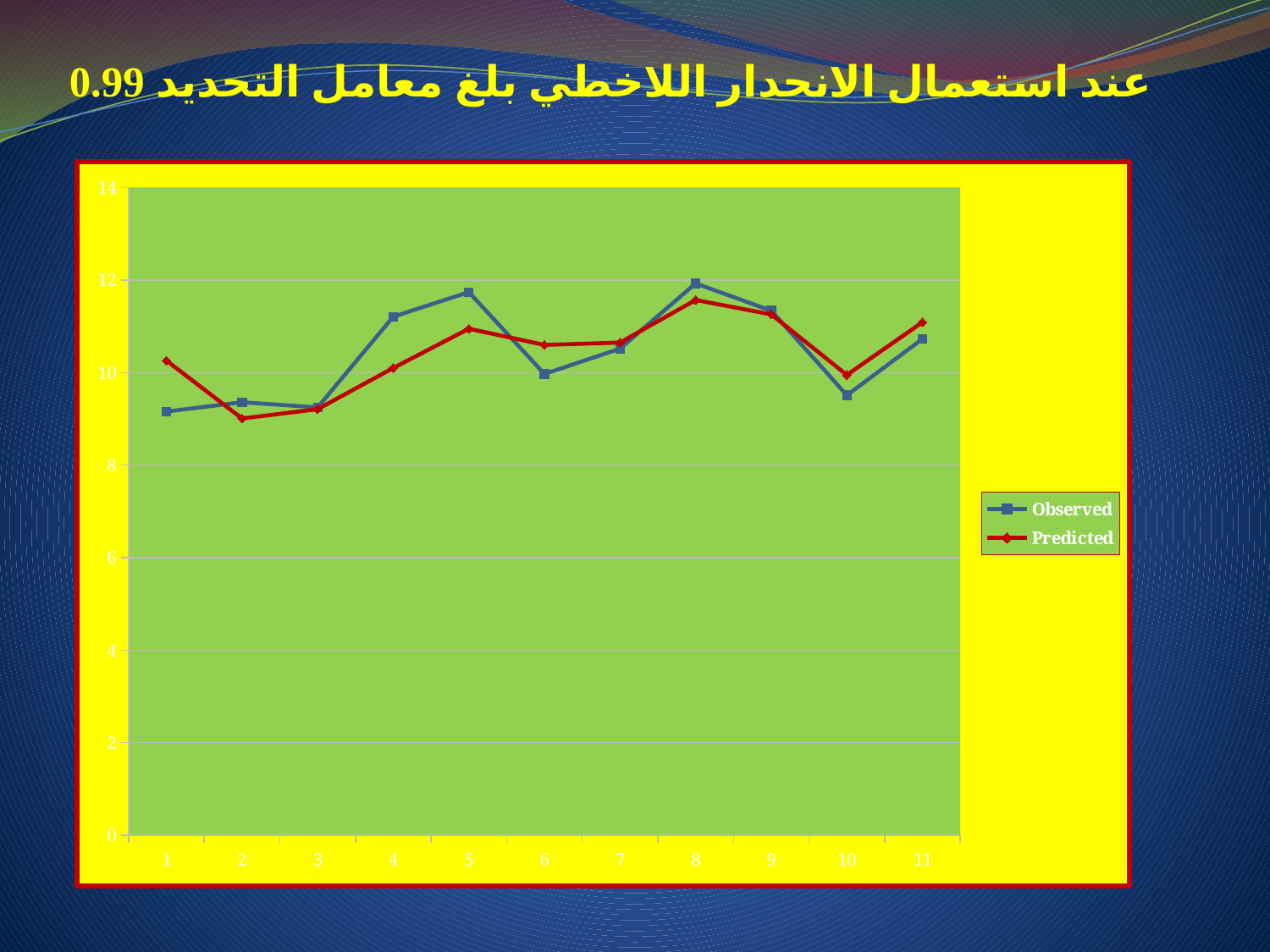
Which series is drawn in red? Predicted How many series does the legend list? 2 Is the Observed value at point 1 greater or less than 10? less At point 1, which series has the higher value, Observed or Predicted? Predicted How many points are plotted along the x axis for each series? 11 Does the Observed series rise or fall from point 8 to point 10? fall Is the Observed value at point 4 greater or less than 10? greater Does the Observed series rise or fall from point 3 to point 5? rise Is the Predicted value at point 1 greater or less than 10? greater At point 4, which series has the higher value, Observed or Predicted? Observed What kind of chart is shown on the slide? line chart